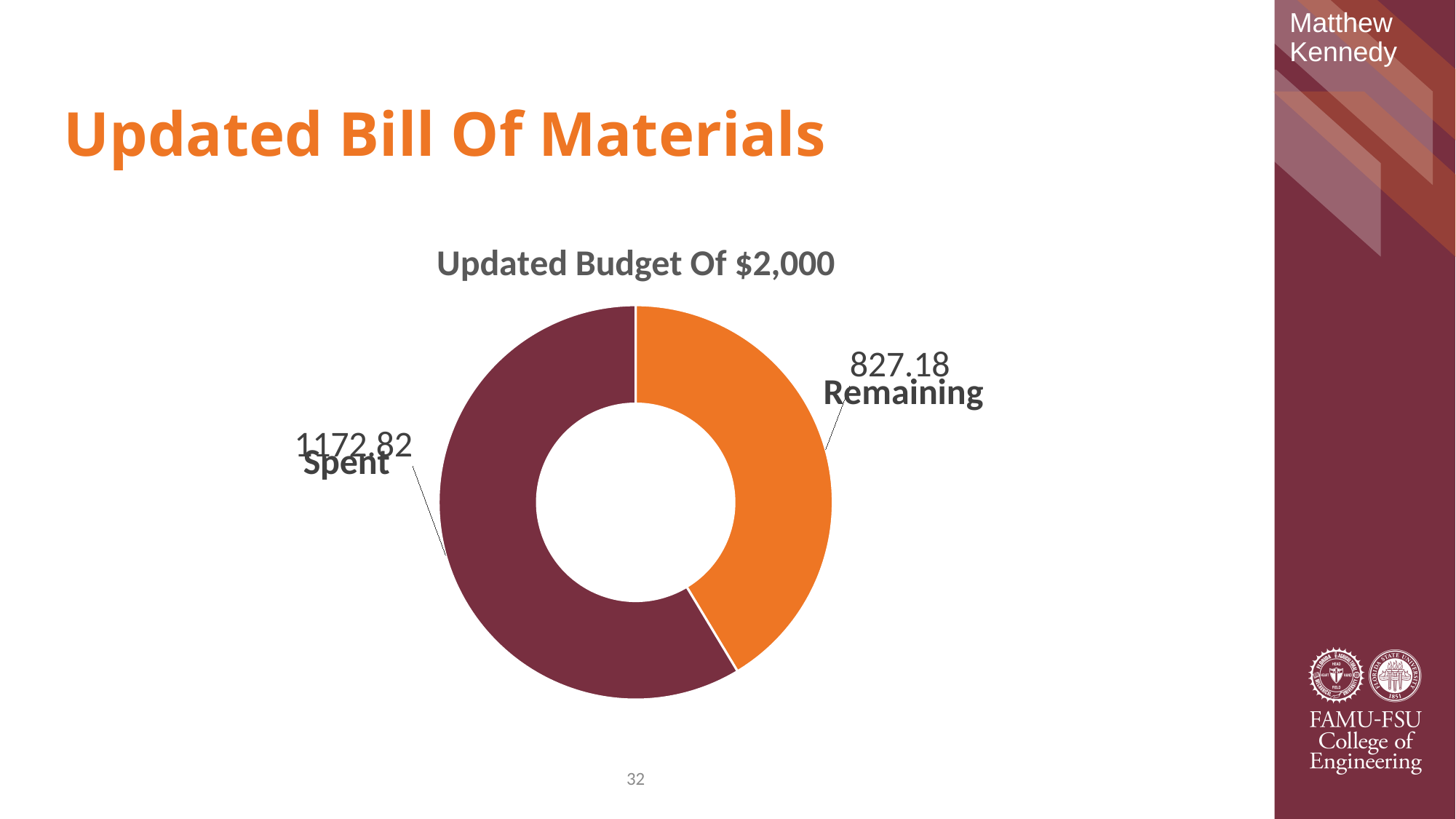
How many slices does the chart have? 2 What is the difference between the Spent and Remaining values? 345.64 What is the value of the Remaining slice? 827.18 What is the title of the chart? Updated Budget Of $2,000 What is the value of the Spent slice? 1172.82 What kind of chart is shown on the slide? doughnut chart What colour is the Remaining slice? orange Which is larger, Spent or Remaining? Spent Which slice is the largest? Spent What is the total of the Spent and Remaining values? 2000.00 Which slice is the smallest? Remaining What share of the total does the Spent slice represent? 58.6%